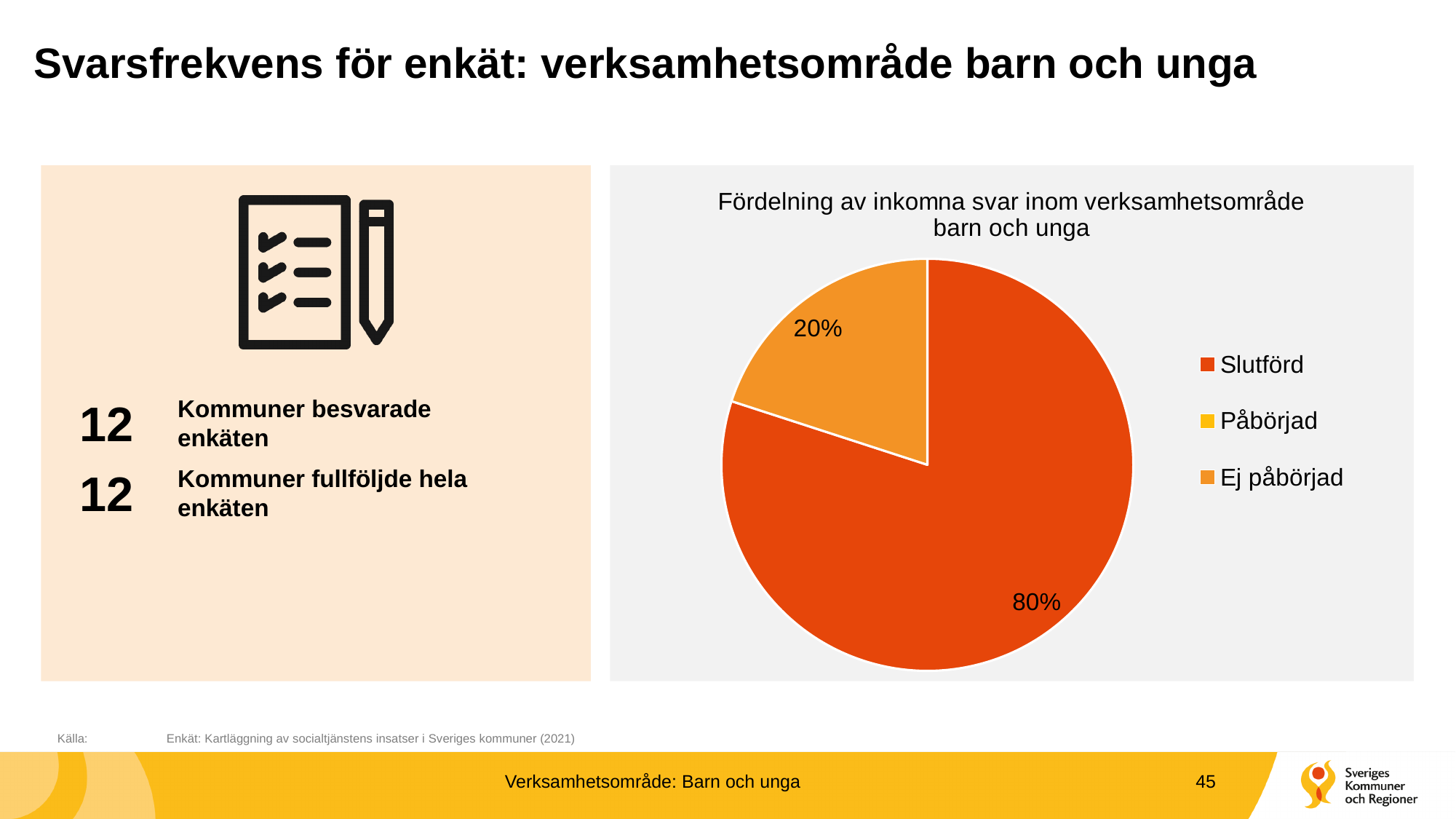
What percentage of the pie chart is labelled for Slutförd? 80% How many entries does the legend of the pie chart list? 3 What kind of chart is shown on the slide? Pie chart What share of the pie does the Slutförd slice represent? 80% What is the title of the pie chart? Fördelning av inkomna svar inom verksamhetsområde barn och unga Which category has the largest slice in the pie chart? Slutförd Which legend entry is shown in yellow? Påbörjad How many slices are visible in the pie chart? 2 What percentage of the pie chart is labelled for Ej påbörjad? 20% Which slice is larger, Slutförd or Ej påbörjad? Slutförd What is the difference in percentage points between the Slutförd slice and the Ej påbörjad slice? 60 percentage points